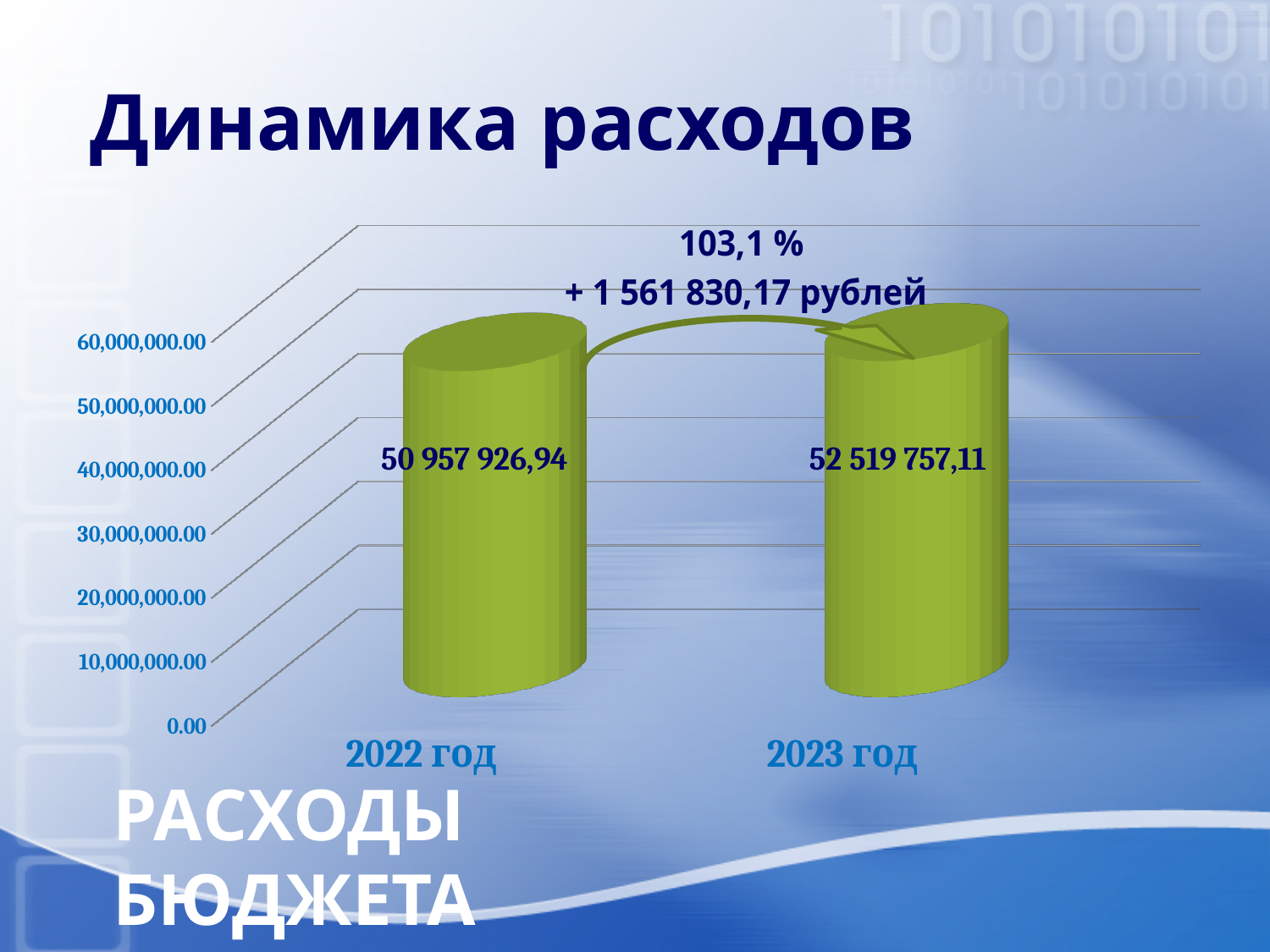
What kind of chart is shown on the slide? bar chart What is the value for 2023 год? 52 519 757,11 Is the value for 2023 год larger or smaller than the value for 2022 год? larger What is the difference between the values for 2023 год and 2022 год? 1 561 830,17 What is the value for 2022 год? 50 957 926,94 Is the value for 2022 год greater or less than 40,000,000.00? greater Do the values rise or fall from 2022 год to 2023 год? rise Is the value for 2023 год greater or less than 60,000,000.00? less Which year has the higher value? 2023 год Which year has the lower value? 2022 год How many categories are shown on the x axis? 2 What percentage is shown in the annotation above the bars? 103,1 %